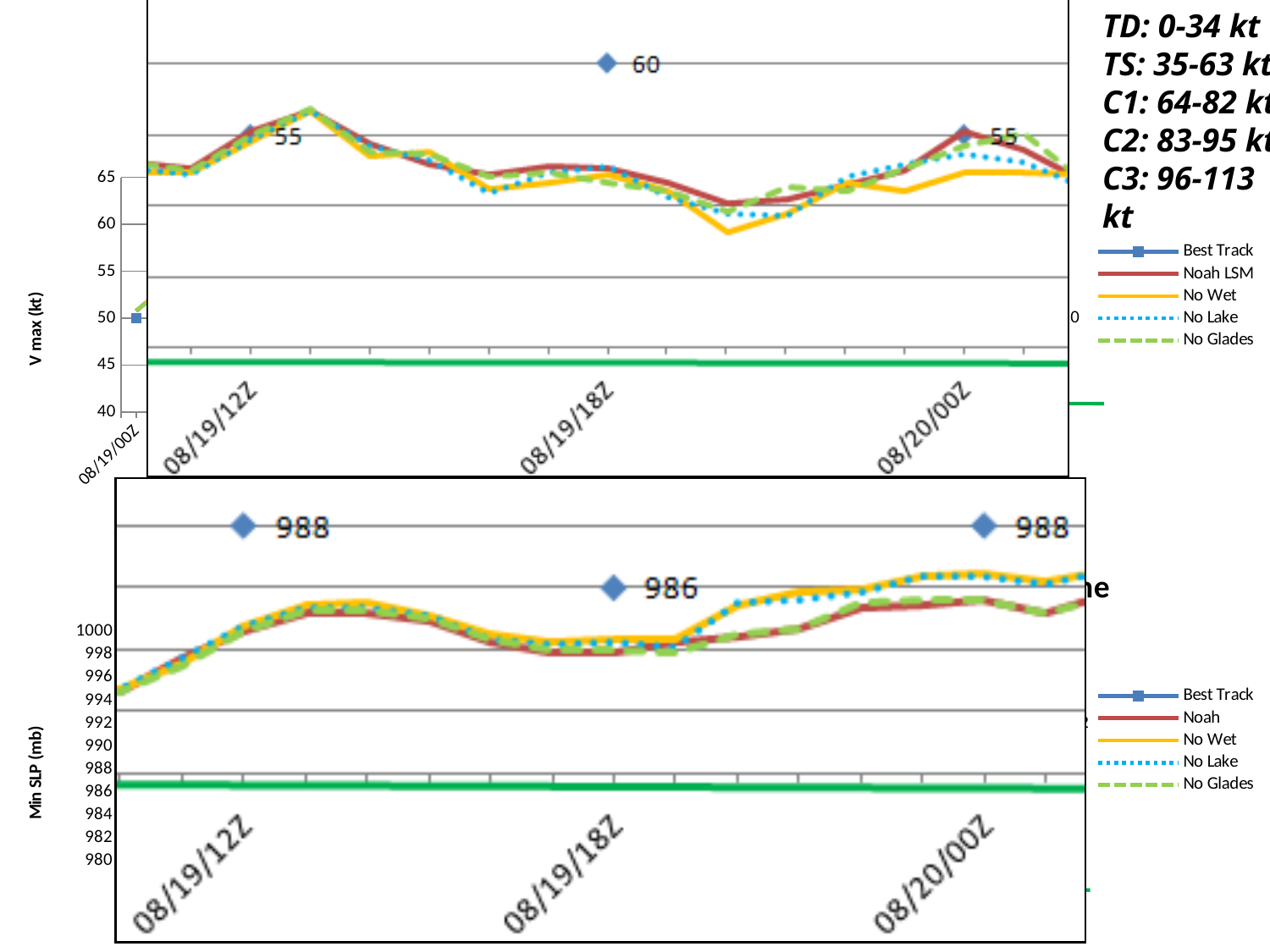
In the top chart (V max), what is the Best Track value at 08/20/00Z? 55 In the bottom chart (Min SLP), which Best Track value is larger: 08/19/12Z or 08/19/18Z? 08/19/12Z In the top chart (V max), what is the Best Track value at 08/19/12Z? 55 In the top chart (V max), what is the difference between the Best Track values at 08/19/18Z and 08/19/12Z? 5 In the top chart (V max), what is the Best Track value at 08/19/18Z? 60 What kind of chart is the top chart (V max)? line chart In the bottom chart (Min SLP), what is the difference between the Best Track values at 08/19/12Z and 08/19/18Z? 2 In the bottom chart (Min SLP), what is the Best Track value at 08/20/00Z? 988 What is the y-axis label of the bottom chart? Min SLP (mb) How many series does the legend of the bottom chart (Min SLP) list? 5 In the bottom chart (Min SLP), what is the Best Track value at 08/19/18Z? 986 How many series does the legend of the top chart (V max) list? 5